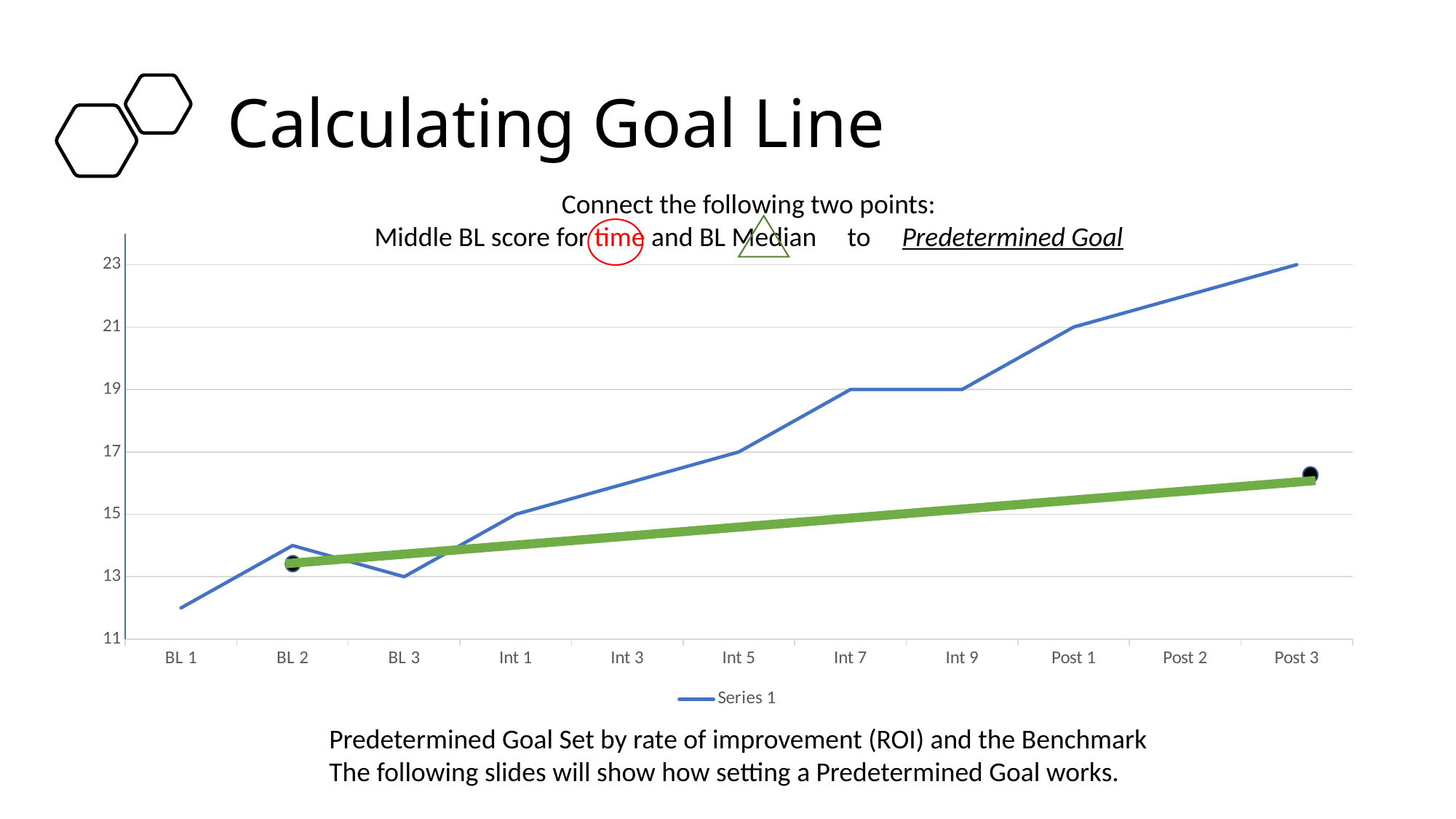
Is the value for BL 1 greater or less than 13? less What is the value of Series 1 at Int 7? 19 What is the value of Series 1 at Int 1? 15 Which category has the highest value for Series 1? Post 3 How many categories are shown along the x axis of the chart? 11 How many series does the chart legend list? 1 What is the value of Series 1 at Post 3? 23 Do the Series 1 values generally rise or fall from BL 1 to Post 3? rise Which category has the lowest value for Series 1? BL 1 Which is larger, the value at Post 1 or the value at Int 5? Post 1 What kind of chart is shown on the slide? line chart What is the name of the series shown in the chart legend? Series 1